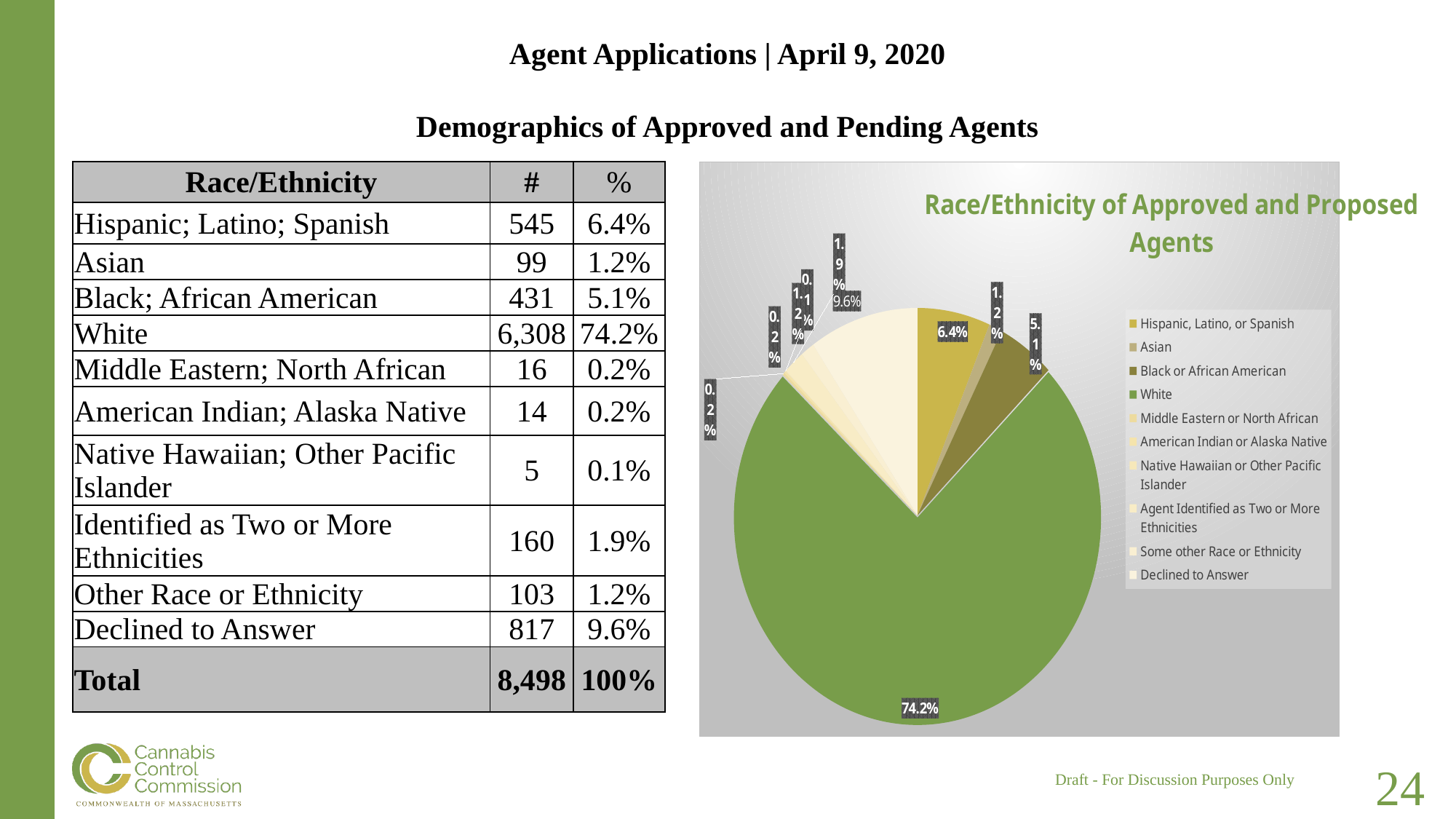
What colour is the White slice in the pie chart? green Which slice is larger in the pie chart: Declined to Answer or Hispanic, Latino, or Spanish? Declined to Answer How many categories does the legend of the pie chart list? 10 What kind of chart is shown on the slide? pie chart By how many percentage points does the White slice exceed the Declined to Answer slice in the pie chart? 64.6 What share of the pie chart is labelled for Hispanic, Latino, or Spanish? 6.4% What share of the pie chart is labelled for White? 74.2% What is the title of the chart on the slide? Race/Ethnicity of Approved and Proposed Agents What share of the pie chart is labelled for Black or African American? 5.1% What share of the pie chart is labelled for Declined to Answer? 9.6% Which category has the largest slice in the pie chart? White Which slice is larger in the pie chart: Hispanic, Latino, or Spanish or Black or African American? Hispanic, Latino, or Spanish